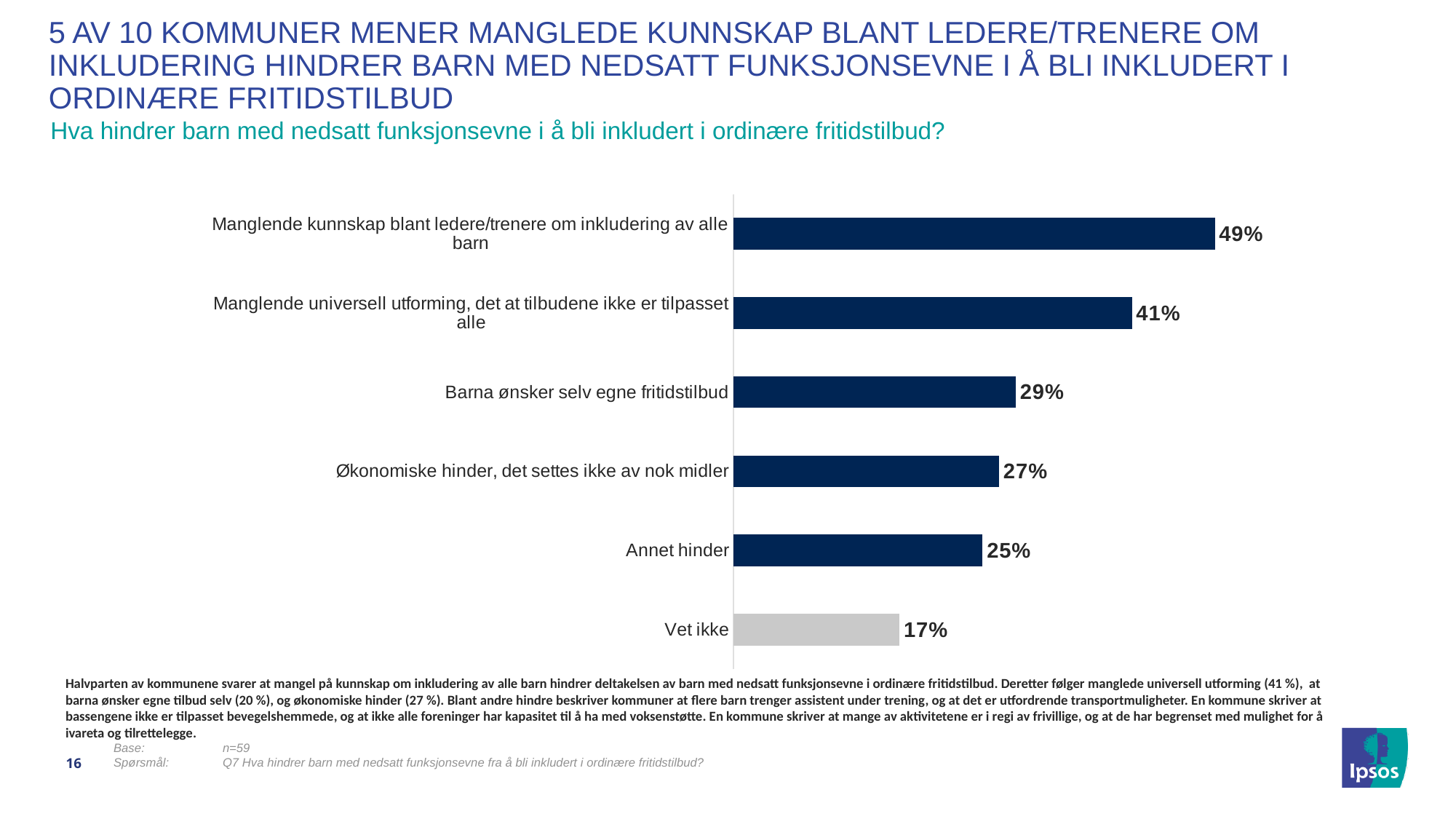
What is the value for "Barna ønsker selv egne fritidstilbud"? 29% What is the difference between the values for "Manglende kunnskap blant ledere/trenere om inkludering av alle barn" and "Manglende universell utforming, det at tilbudene ikke er tilpasset alle"? 8% What is the value for "Manglende kunnskap blant ledere/trenere om inkludering av alle barn"? 49% Which is larger: the value for "Barna ønsker selv egne fritidstilbud" or the value for "Økonomiske hinder, det settes ikke av nok midler"? Barna ønsker selv egne fritidstilbud Which bar is shown in a different colour (grey) from the others? Vet ikke Which category has the lowest value? Vet ikke Which category has the highest value? Manglende kunnskap blant ledere/trenere om inkludering av alle barn What is the value for "Annet hinder"? 25% What is the difference between the values for "Økonomiske hinder, det settes ikke av nok midler" and "Vet ikke"? 10% What is the value for "Vet ikke"? 17% How many categories are shown in the chart? 6 What kind of chart is shown on the slide? Bar chart